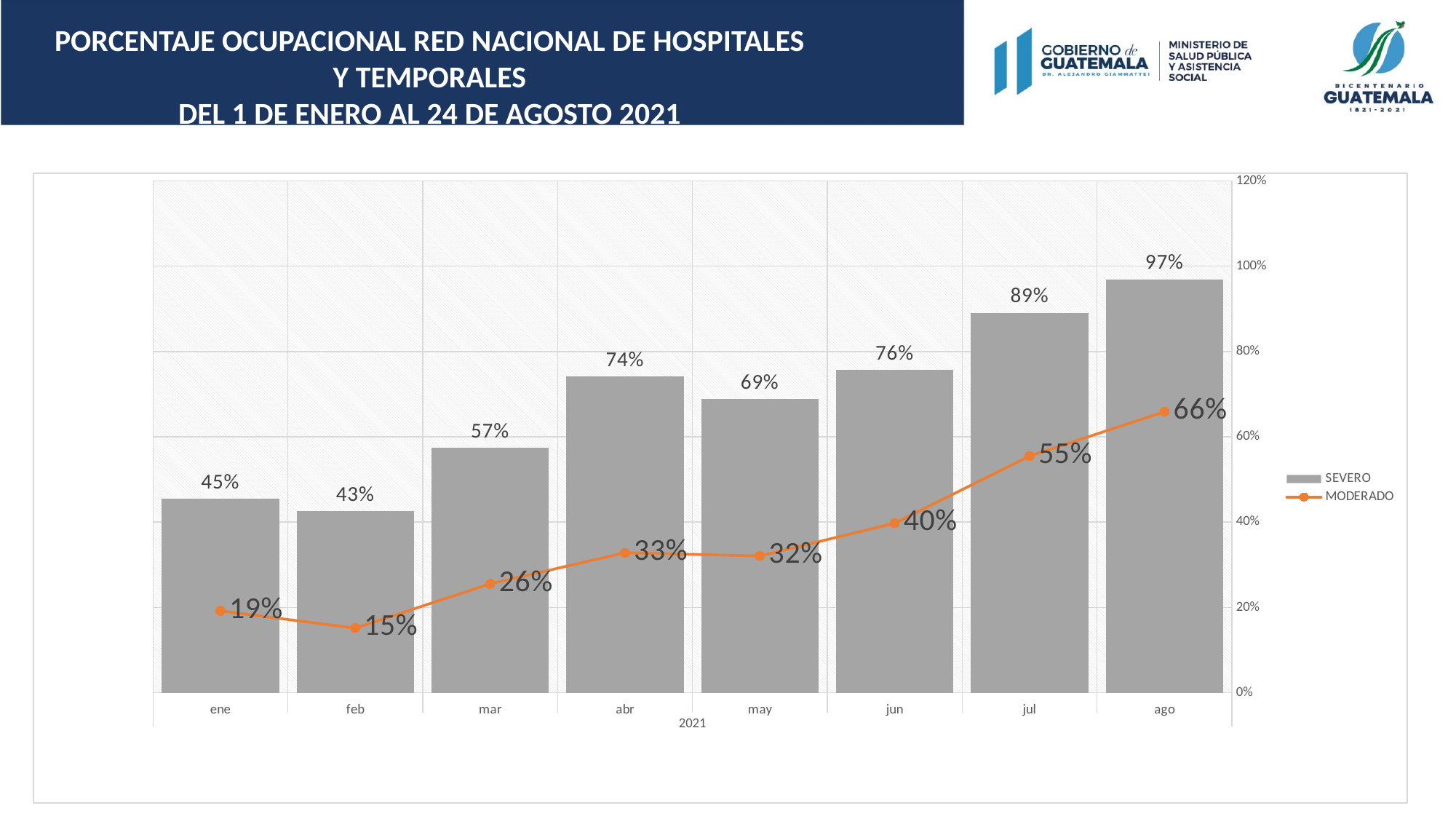
What is the MODERADO value for jul? 55% Which is larger, the SEVERO value for abr or for may? abr What is the SEVERO value for abr? 74% What kind of chart is shown on the slide? Combined bar and line chart What is the difference between the MODERADO values for jun and may? 8% Do the SEVERO values generally rise or fall from ene to ago? rise How many months are shown on the x axis? 8 What is the SEVERO value for feb? 43% Which month has the lowest MODERADO value? feb Which month has the highest SEVERO value? ago How many series does the legend list? 2 What is the difference between the SEVERO values for ago and jul? 8%